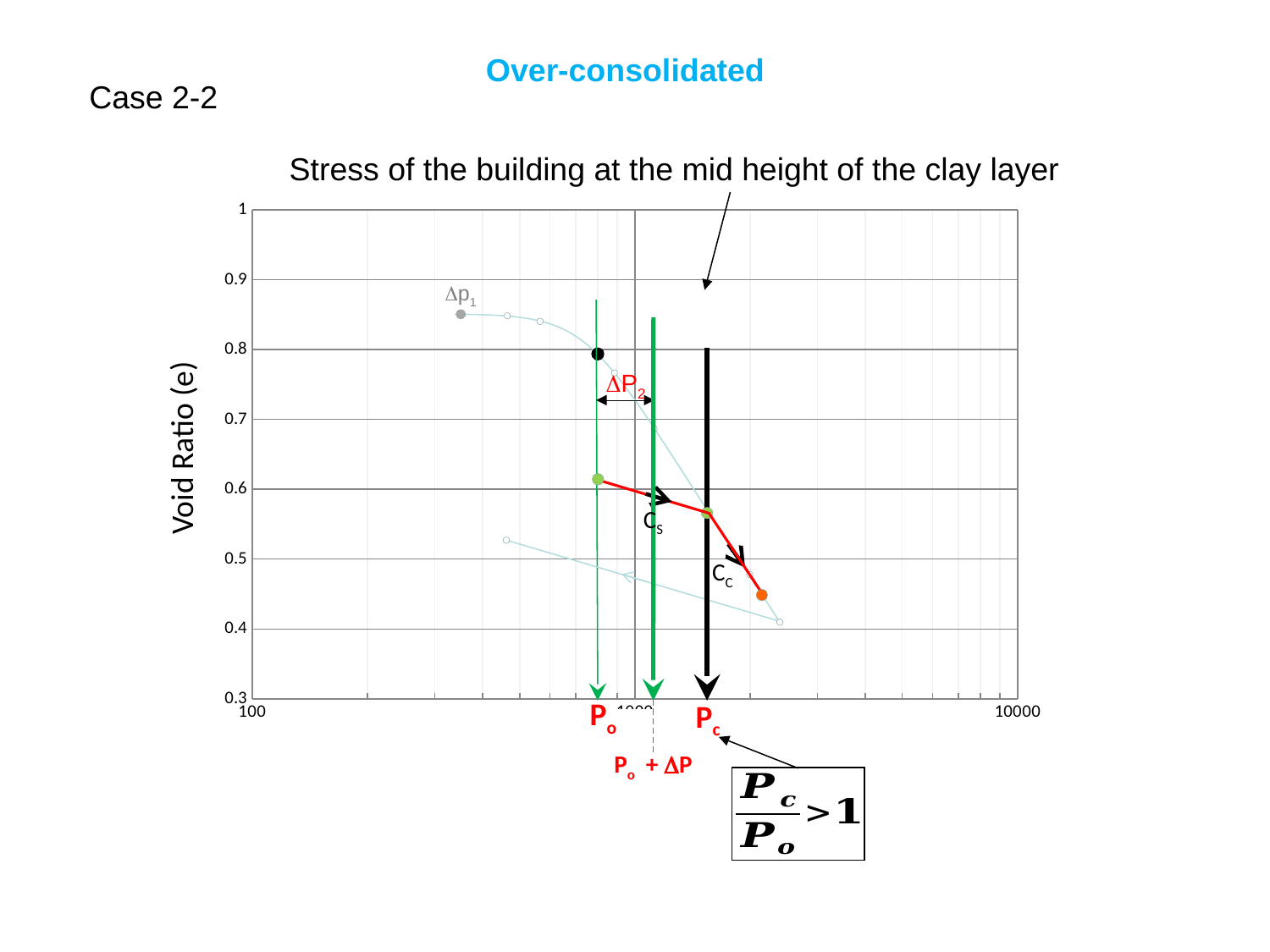
What is the label of the vertical axis of the chart? Void Ratio (e) Along the red line, does the void ratio rise or fall as the stress increases from Po to Pc and beyond? fall What is the highest value shown on the vertical axis of the chart? 1 Is the void ratio at the point labelled Δp1 greater or less than 0.8? greater What inequality is shown in the box below the chart? Pc/Po > 1 Is the void ratio at the orange point on the red line greater or less than 0.5? less What kind of chart is shown on the slide? line chart How many vertical arrows pointing down to the horizontal axis are drawn on the chart? 3